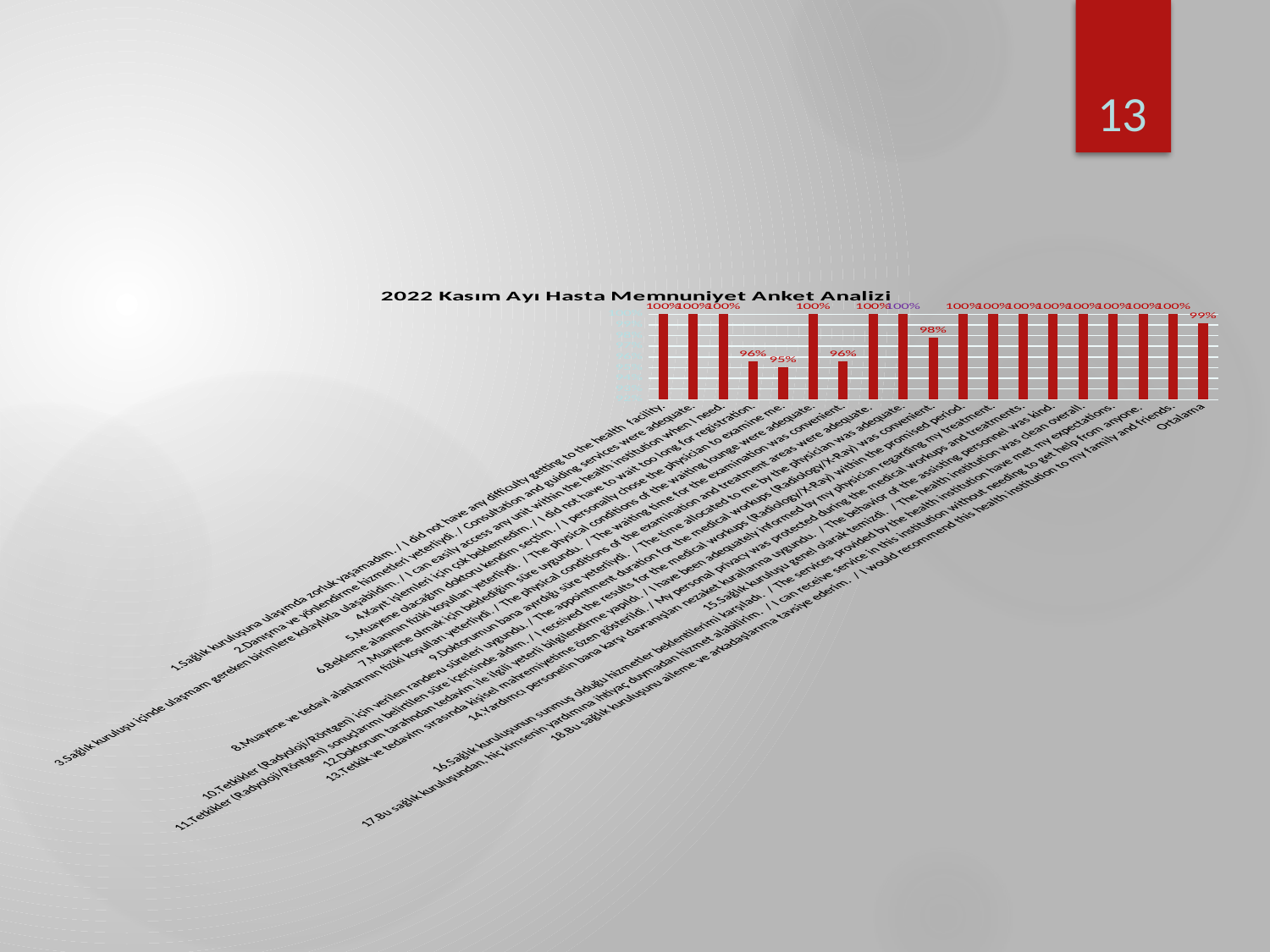
What kind of chart is shown on the slide? Bar chart What is the title of the chart? 2022 Kasım Ayı Hasta Memnuniyet Anket Analizi Which is larger, the value for item 10 or the value for item 7? Item 10 What is the value for item 10 ('Tetkikler (Radyoloji/Röntgen) için verilen randevu süreleri uygundu')? 98% How many bars in the chart have a value of 100%? 14 What is the lowest value shown in the chart? 95% What is the value for item 5 ('Muayene olacağım doktoru kendim seçtim')? 95% What is the value for item 4 ('Kayıt işlemleri için çok beklemedim')? 96% Which item has the lowest value in the chart? 5.Muayene olacağım doktoru kendim seçtim How many bars are plotted in the chart? 19 What is the value of the 'Ortalama' bar? 99% What is the difference between the value for item 4 (96%) and item 5 (95%)? 1%